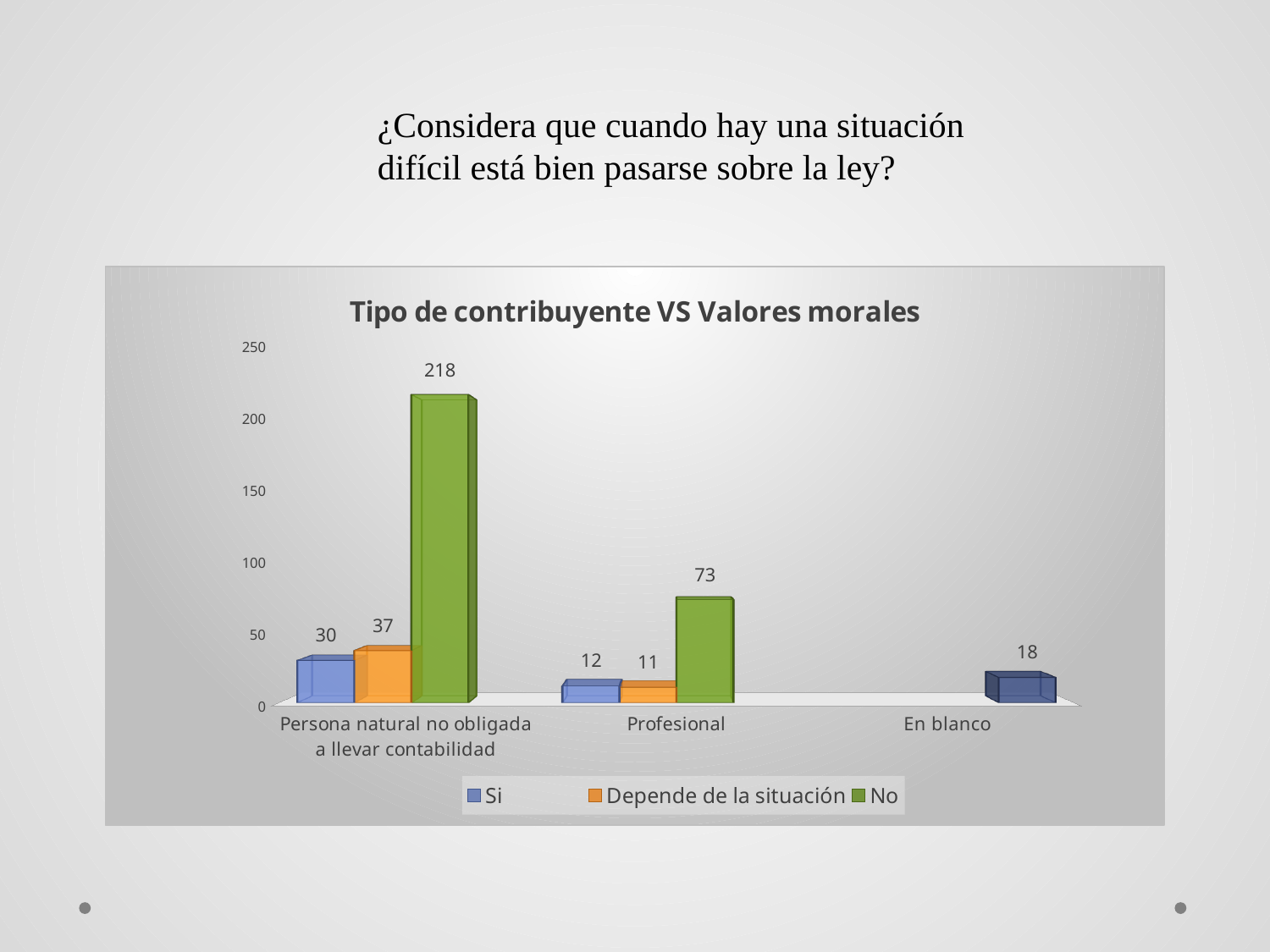
What value is labelled on the bar in the "En blanco" category? 18 What is the value for "Depende de la situación" in the "Persona natural no obligada a llevar contabilidad" category? 37 Is the value for "No" in the "Profesional" category greater or less than 100? less In the "Persona natural no obligada a llevar contabilidad" category, which is larger: "Si" or "Depende de la situación"? Depende de la situación What is the value for "Si" in the "Profesional" category? 12 What is the value for "No" in the "Persona natural no obligada a llevar contabilidad" category? 218 What is the difference between the "No" values for "Persona natural no obligada a llevar contabilidad" and "Profesional"? 145 What is the title of the chart? Tipo de contribuyente VS Valores morales How many series does the legend list? 3 Which series has the lowest value in the "Profesional" category? Depende de la situación Which category has the highest value for the "No" series? Persona natural no obligada a llevar contabilidad How many categories are shown on the x axis? 3